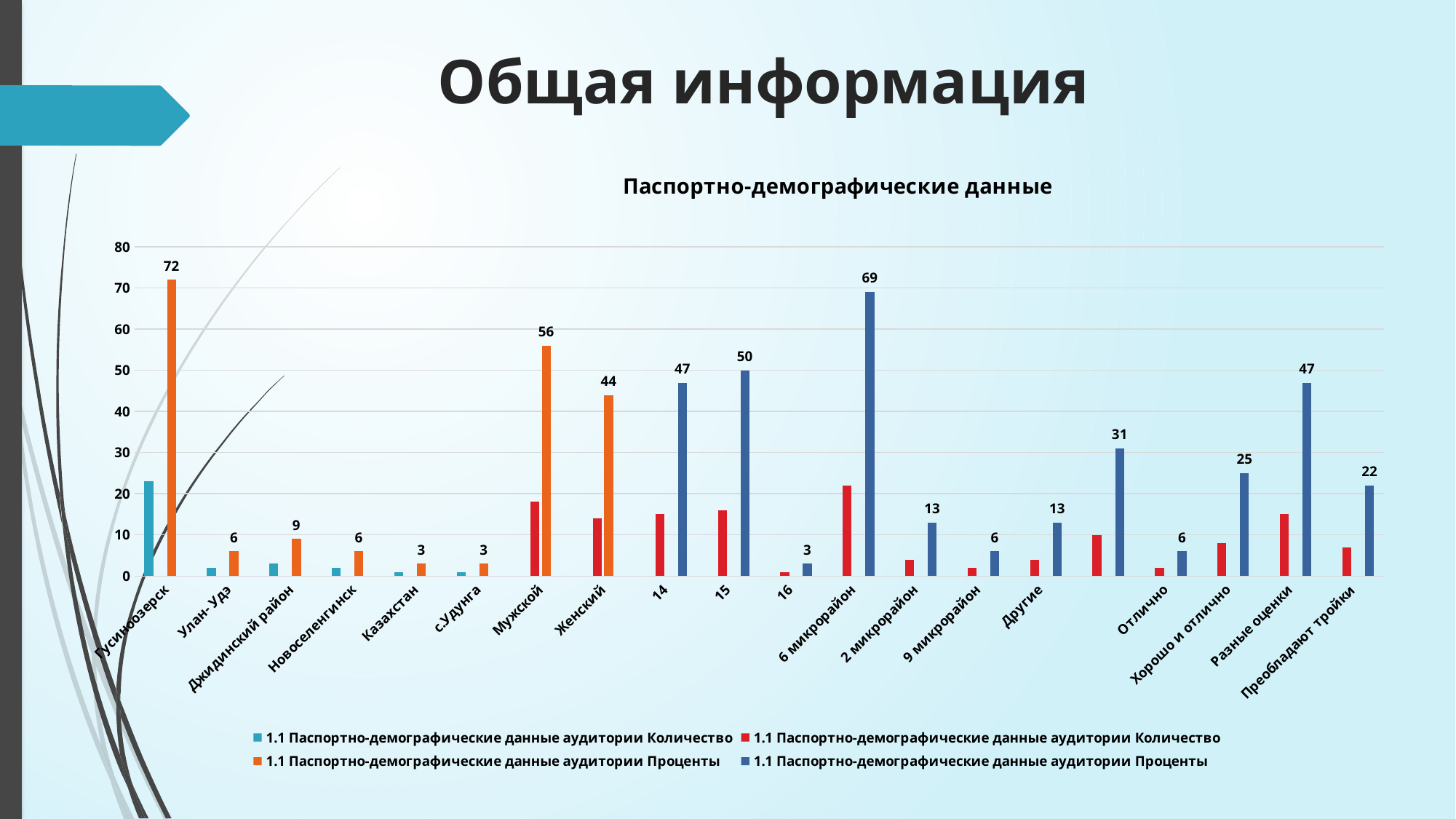
What type of chart is shown on the slide? bar chart What is the labelled percentage value for Преобладают тройки? 22 What is the difference between the labelled percentage values for Мужской and Женский? 12 How many series does the legend list? 4 Is the unlabelled count bar for Гусиноозерск greater or less than 20? greater What is the labelled percentage value for Гусиноозерск? 72 Is the unlabelled count bar for Мужской greater or less than 10? greater What is the difference between the labelled percentage values for 6 микрорайон and 2 микрорайон? 56 Which has the larger labelled percentage value, 14 or 15? 15 What is the labelled percentage value for 6 микрорайон? 69 Which category has the highest labelled percentage bar? Гусиноозерск What is the labelled percentage value for Мужской? 56